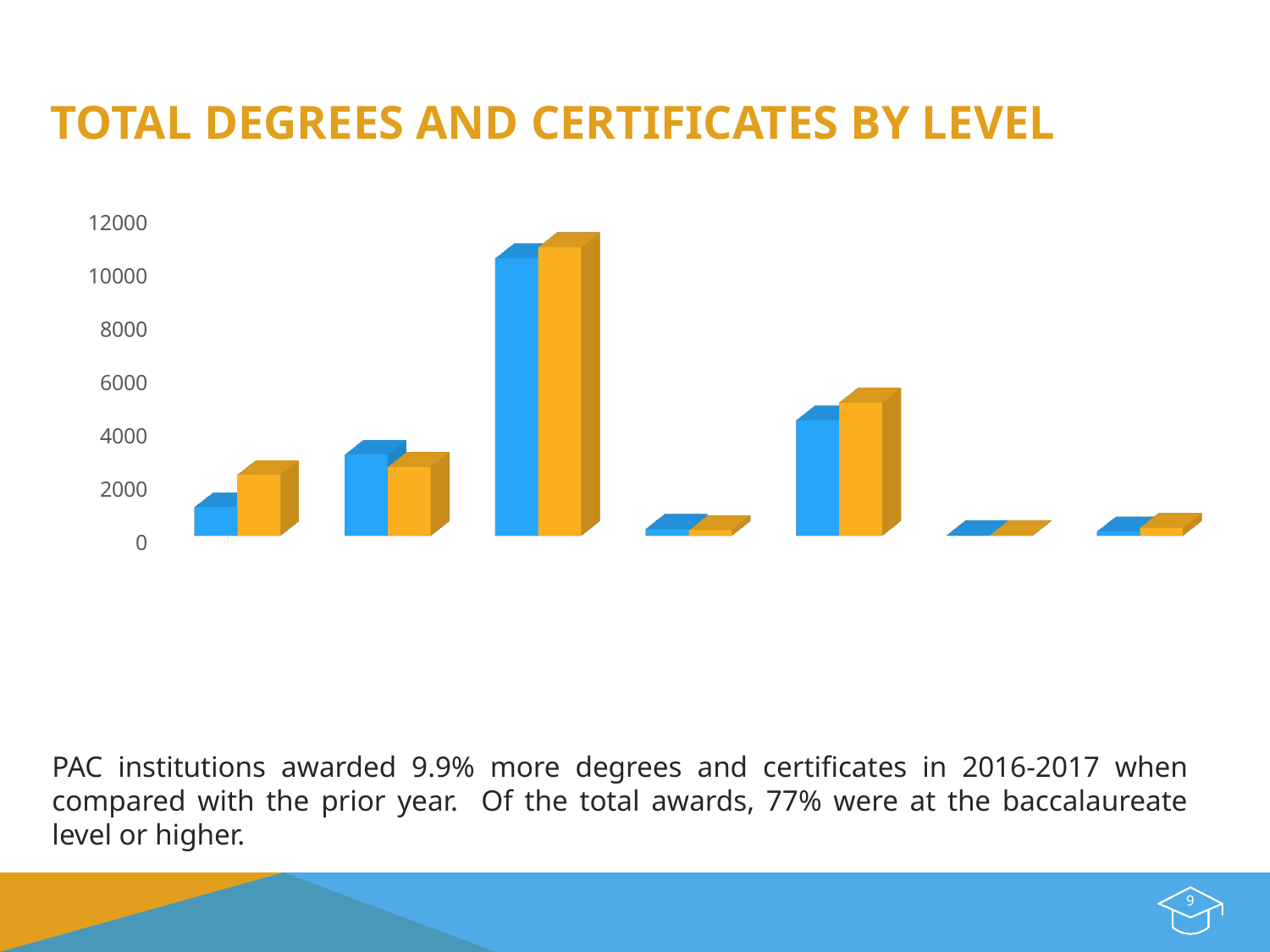
In the first group from the left, which bar is taller, the blue one or the orange one? the orange one Which group of bars, counting from the left, is the tallest? the third group Are the bars in the fourth group from the left greater or less than 2000? less Which is larger, the blue bar in the third group from the left or the blue bar in the fifth group from the left? the third group How many bars are there in each group? 2 What is the highest value shown on the vertical axis? 12000 Is the value of the blue bar in the fifth group from the left greater or less than 8000? less In the second group from the left, which bar is taller, the blue one or the orange one? the blue one How many groups of bars are plotted along the x axis? 7 Is the value of the orange bar in the third group from the left greater or less than 8000? greater What kind of chart is shown on the slide? bar chart What is the title of the chart? Total Degrees and Certificates by Level